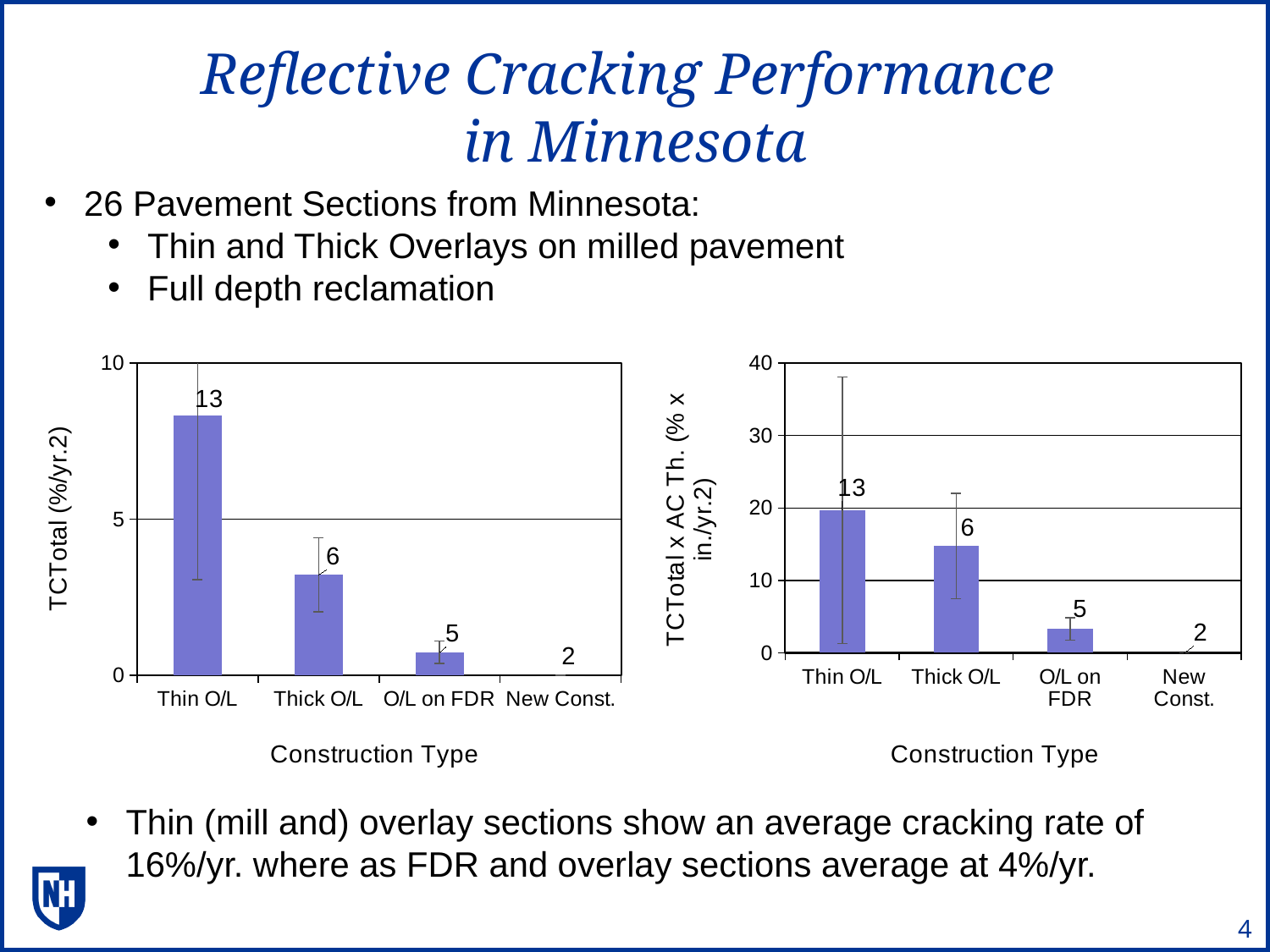
In the left chart, is the TCTotal value for Thick O/L greater or less than 5? less In the right chart, which construction type has the highest bar? Thin O/L In the left chart, which construction type has the highest TCTotal bar? Thin O/L In the left chart, which bar is taller: Thick O/L or O/L on FDR? Thick O/L In the right chart, do the bar values rise or fall moving from Thin O/L to New Const. along the x axis? fall In the right chart, is the value for O/L on FDR greater or less than 10? less In the left chart, which construction type has the lowest TCTotal bar? New Const. What kind of chart is the left chart on the slide? bar chart In the right chart, is the value for Thick O/L greater or less than 20? less How many construction types are shown on the x axis of the left chart? 4 What is the x-axis title of the right chart? Construction Type